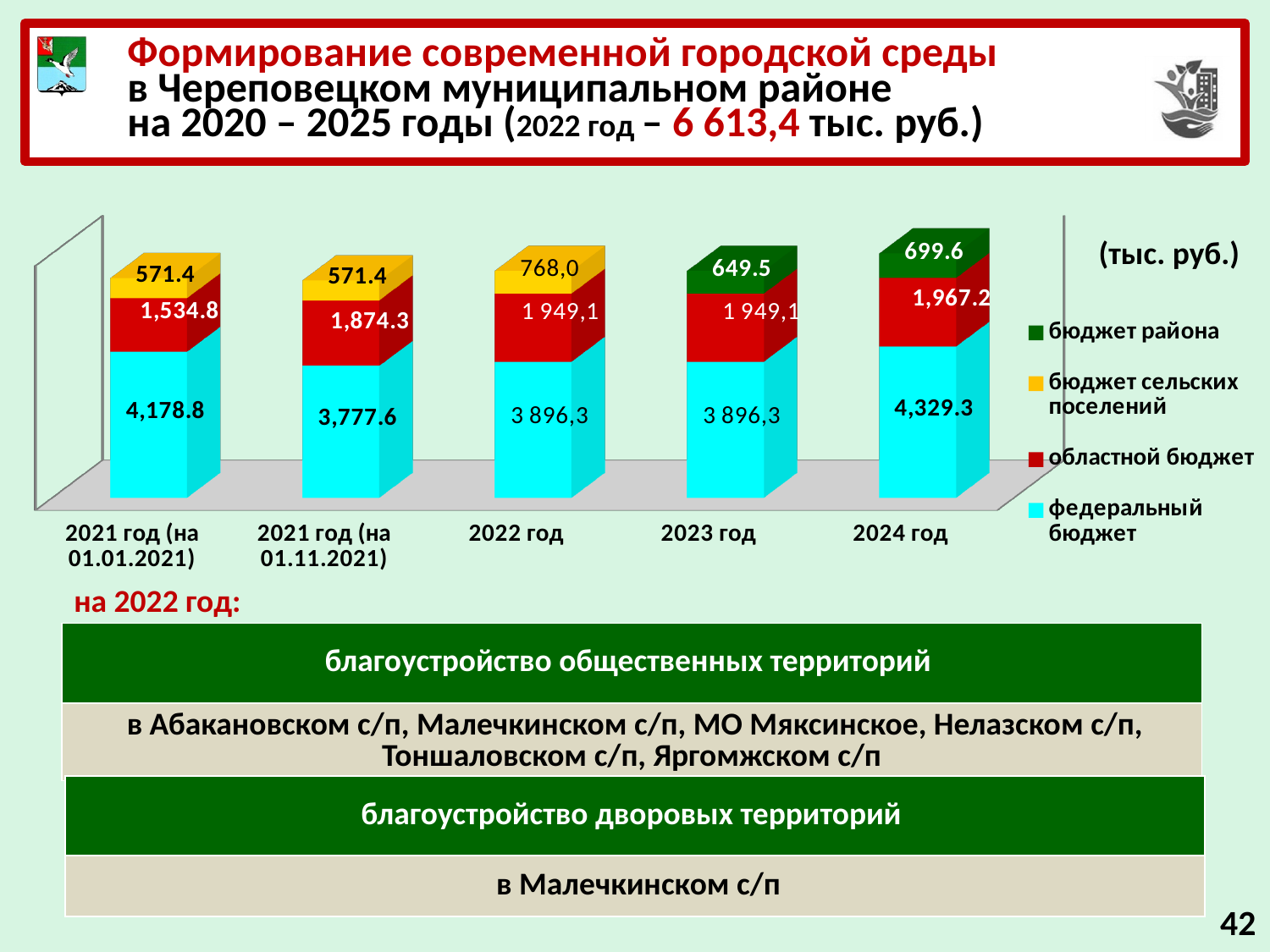
Which category has the highest федеральный бюджет value? 2024 год What kind of chart is shown on the slide? Stacked bar chart How many categories are shown on the x axis of the chart? 5 What is the value of the областной бюджет segment for 2022 год? 1 949,1 What is the total of the stacked bar for 2022 год? 6 613,4 What is the difference between the федеральный бюджет values for 2021 год (на 01.01.2021) and 2021 год (на 01.11.2021)? 401.2 Which is larger: the областной бюджет value for 2024 год or for 2022 год? 2024 год Which category has the lowest федеральный бюджет value? 2021 год (на 01.11.2021) How many series does the chart legend list? 4 What is the value of the бюджет сельских поселений segment for 2021 год (на 01.11.2021)? 571.4 What is the value of the бюджет района segment for 2023 год? 649.5 What is the value of the федеральный бюджет segment for 2024 год? 4,329.3